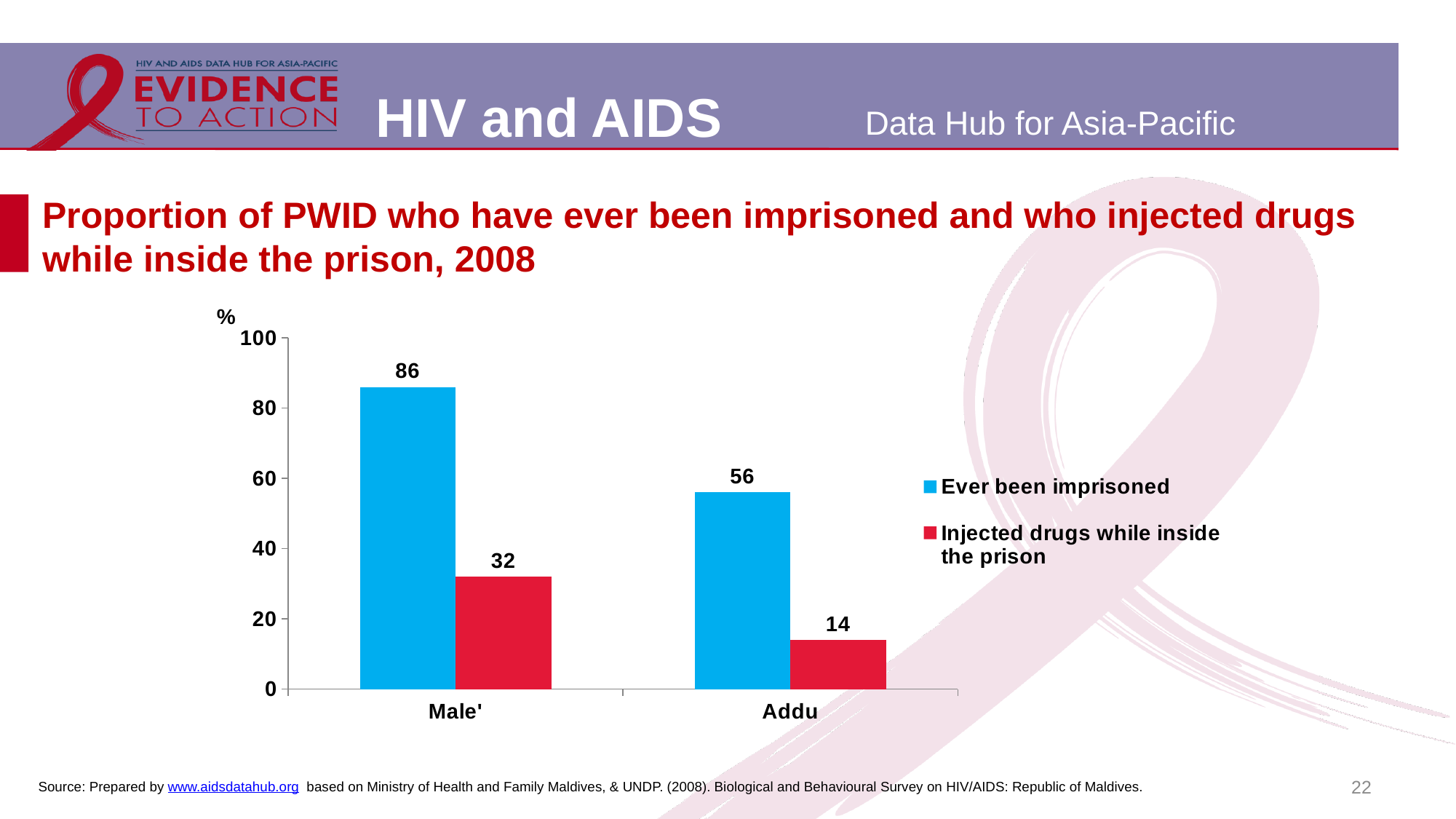
What is the difference between the 'Ever been imprisoned' values for Male' and Addu? 30 Which location has the higher proportion of PWID who have ever been imprisoned? Male' What percentage of PWID in Male' have ever been imprisoned? 86 How many series does the legend list? 2 Which bar in the chart has the lowest value? Injected drugs while inside the prison, Addu In Male', how much higher is the 'Ever been imprisoned' value than the 'Injected drugs while inside the prison' value? 54 What type of chart is shown on the slide? Bar chart Is the 'Injected drugs while inside the prison' value larger in Male' or in Addu? Male' How many locations are shown on the x axis of the chart? 2 What is the value for 'Injected drugs while inside the prison' in Male'? 32 What percentage of PWID in Addu injected drugs while inside the prison? 14 What is the value for 'Ever been imprisoned' in Addu? 56